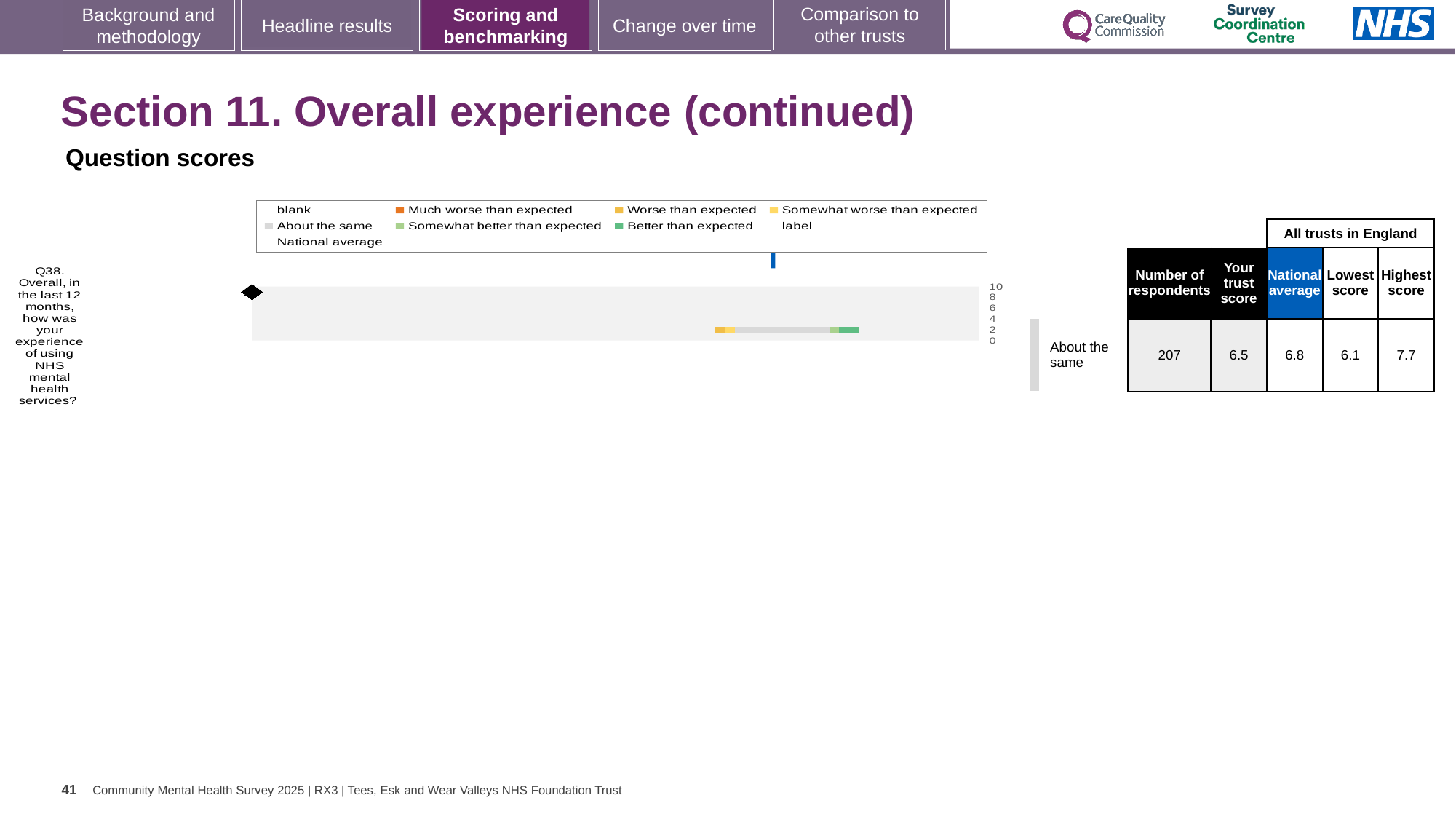
What is the highest value shown on the chart's score axis? 10 What is the difference between the national average and the trust score for Q38? 0.3 Which is larger for Q38: the trust score or the national average? National average How many respondents answered Q38? 207 How many survey questions are plotted on the chart? 1 What kind of chart is used to show the Q38 question score? bar chart Which benchmarking category is the trust's Q38 score placed in? About the same What is the trust score for Q38 (Overall, in the last 12 months, how was your experience of using NHS mental health services?)? 6.5 What is the difference between the highest and lowest trust scores for Q38? 1.6 What is the lowest score among all trusts in England for Q38? 6.1 What is the national average score for Q38? 6.8 What is the highest score among all trusts in England for Q38? 7.7